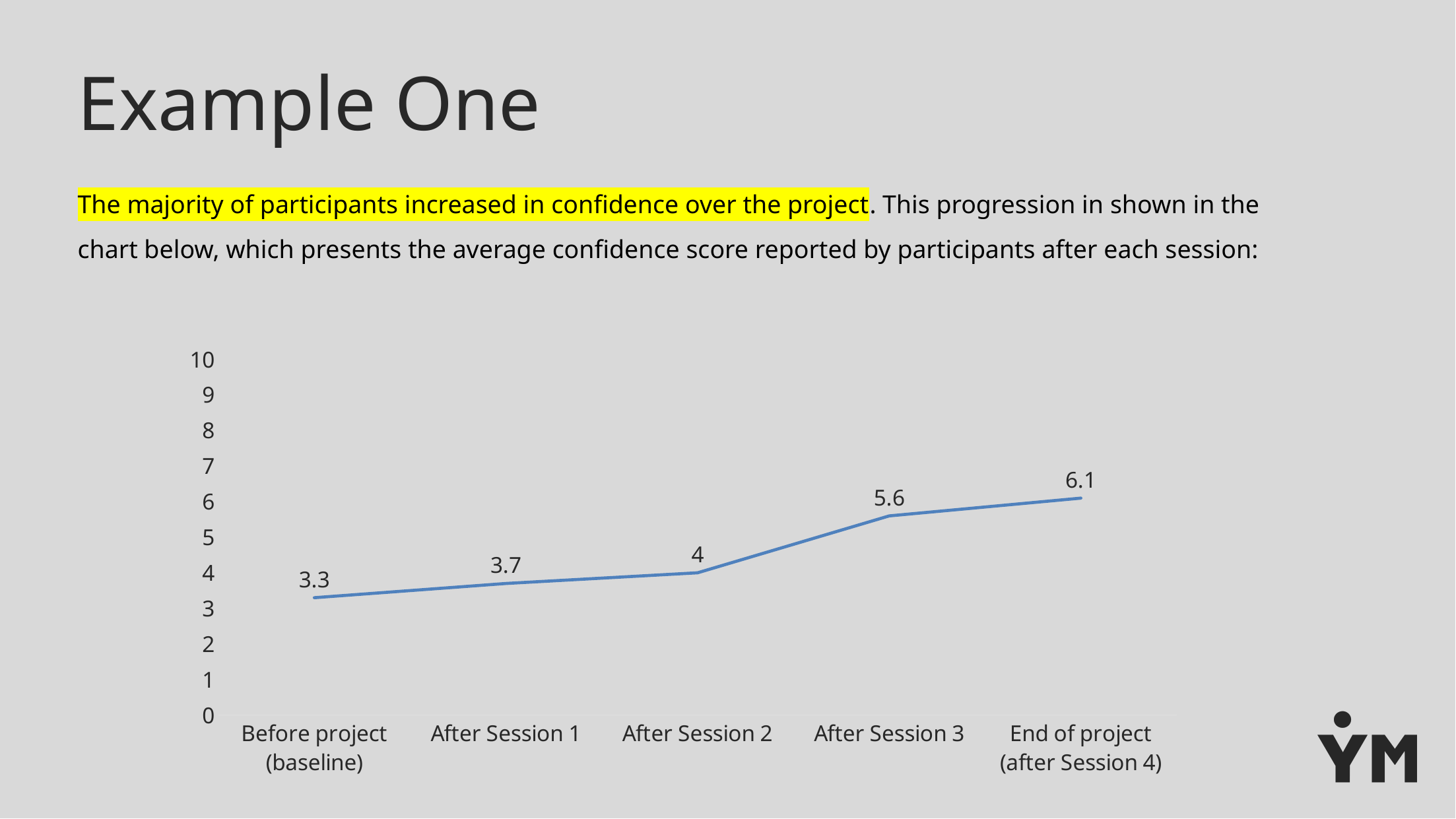
Do the average confidence scores rise or fall from the baseline to the end of the project? Rise At which point is the average confidence score lowest? Before project (baseline) How many points are plotted on the chart? 5 What is the average confidence score after Session 2? 4 What is the average confidence score after Session 1? 3.7 Which is larger, the score after Session 3 or the score after Session 2? After Session 3 What is the average confidence score at the end of the project (after Session 4)? 6.1 At which point is the average confidence score highest? End of project (after Session 4) What kind of chart is shown on the slide? Line chart What is the average confidence score before the project (baseline)? 3.3 What is the average confidence score after Session 3? 5.6 What is the difference between the end of project score and the baseline score? 2.8